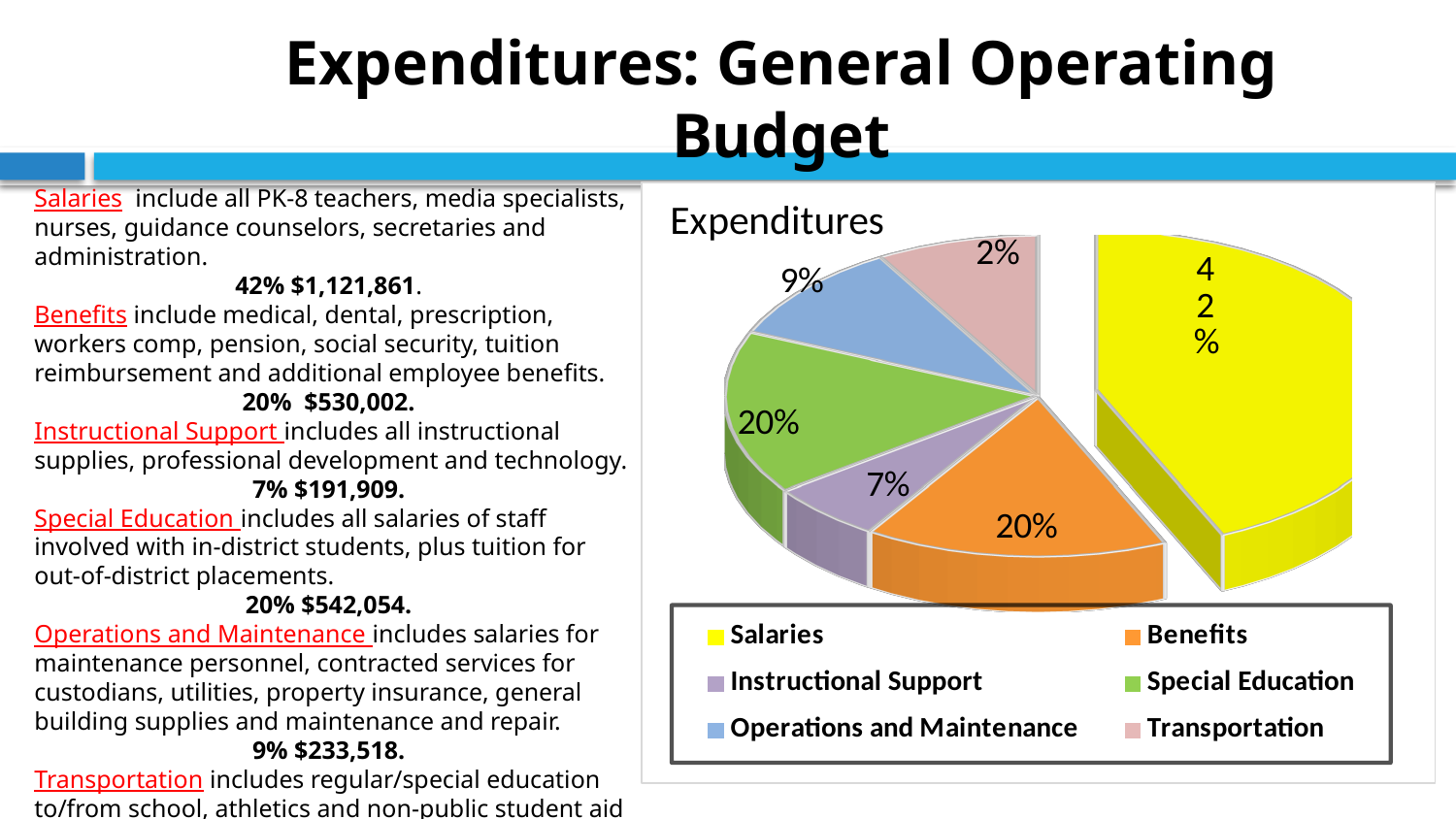
What kind of chart is shown on the slide? pie chart Which category has the largest share of expenditures? Salaries What percentage of expenditures goes to Operations and Maintenance? 9% What percentage of expenditures goes to Salaries? 42% How many categories does the pie chart show? 6 What is the difference in percentage points between Salaries and Benefits? 22 What is the chart's title? Expenditures What colour is the Salaries slice in the pie chart? yellow What percentage of expenditures goes to Instructional Support? 7% What percentage of expenditures goes to Transportation? 2% Which is larger, the share for Operations and Maintenance or the share for Instructional Support? Operations and Maintenance Which category has the smallest share of expenditures? Transportation